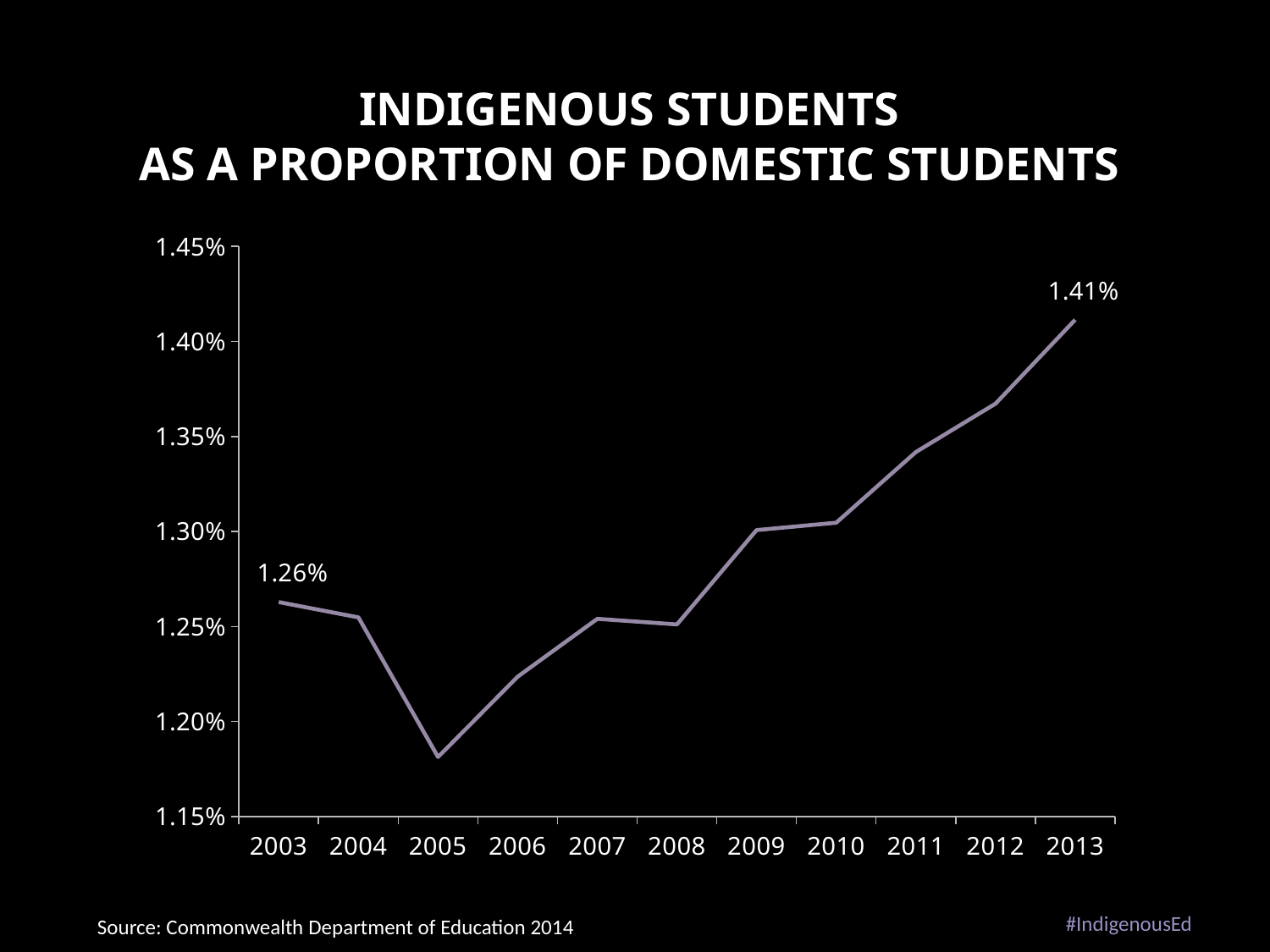
Is the value for 2005 greater or less than 1.20%? less Which is larger, the value for 2009 or the value for 2005? 2009 How many years are plotted on the x axis? 11 Which year has the highest value? 2013 What is the value for 2013? 1.41% Which year has the lowest value? 2005 Is the value for 2012 greater or less than 1.35%? greater What is the title of the chart? Indigenous Students as a Proportion of Domestic Students Do the values rise or fall from 2005 to 2013? rise What is the difference between the 2013 value and the 2003 value? 0.15% What kind of chart is this? line chart What is the value for 2003? 1.26%